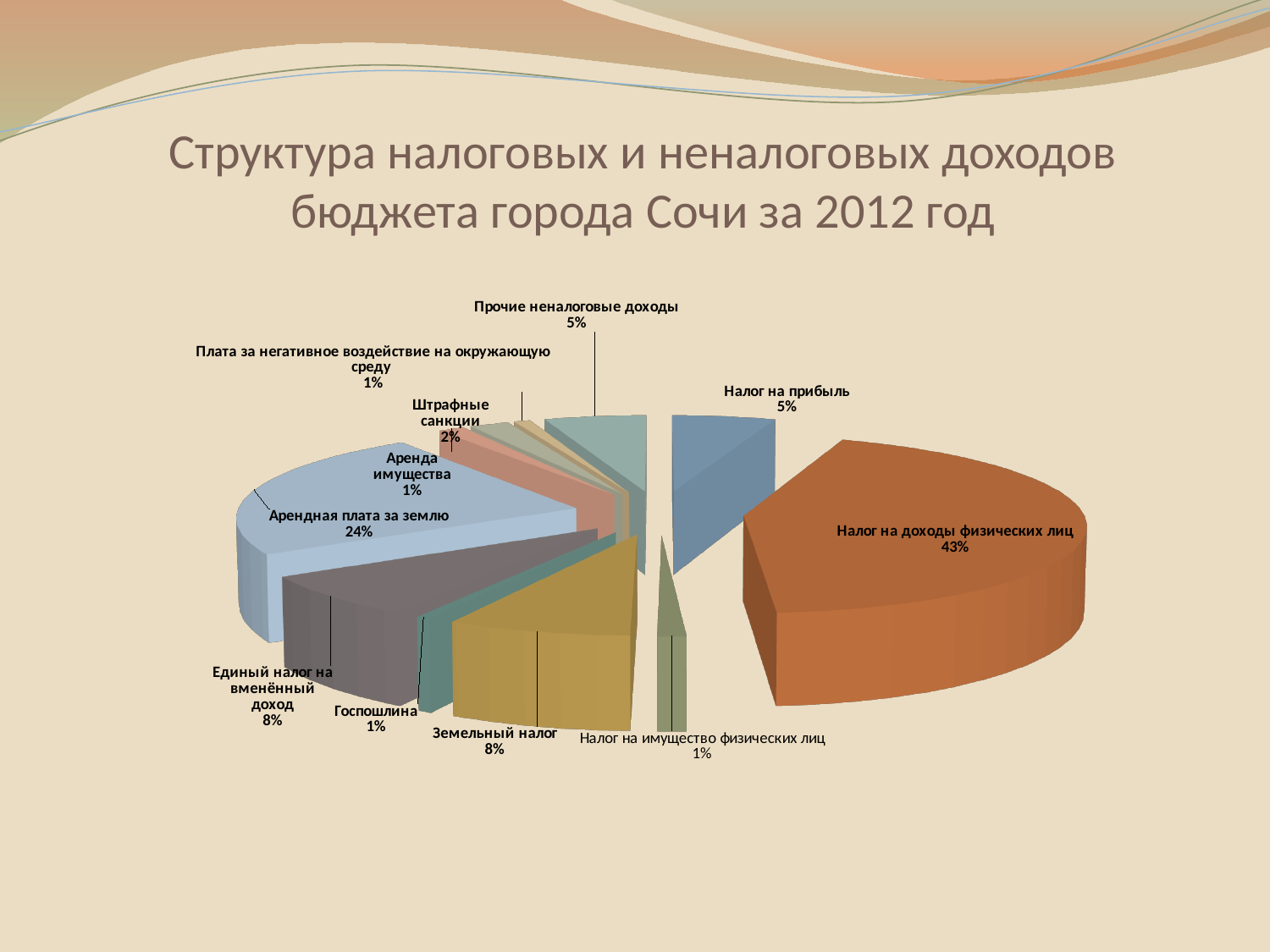
Which is larger: the share of "Земельный налог" or the share of "Налог на прибыль"? Земельный налог What is the value shown for "Арендная плата за землю"? 24% What is the combined share of "Земельный налог" and "Единый налог на вменённый доход"? 16% What is the value shown for "Штрафные санкции"? 2% What is the value shown for "Единый налог на вменённый доход"? 8% Which category has the largest share of the pie? Налог на доходы физических лиц What share of the pie does "Налог на доходы физических лиц" represent? 43% What is the difference between the shares of "Налог на доходы физических лиц" and "Арендная плата за землю"? 19% What is the value shown for "Налог на прибыль"? 5% What year does the slide title say the budget revenue structure refers to? 2012 What kind of chart is shown on the slide? pie chart How many categories (slices) does the pie chart have? 11